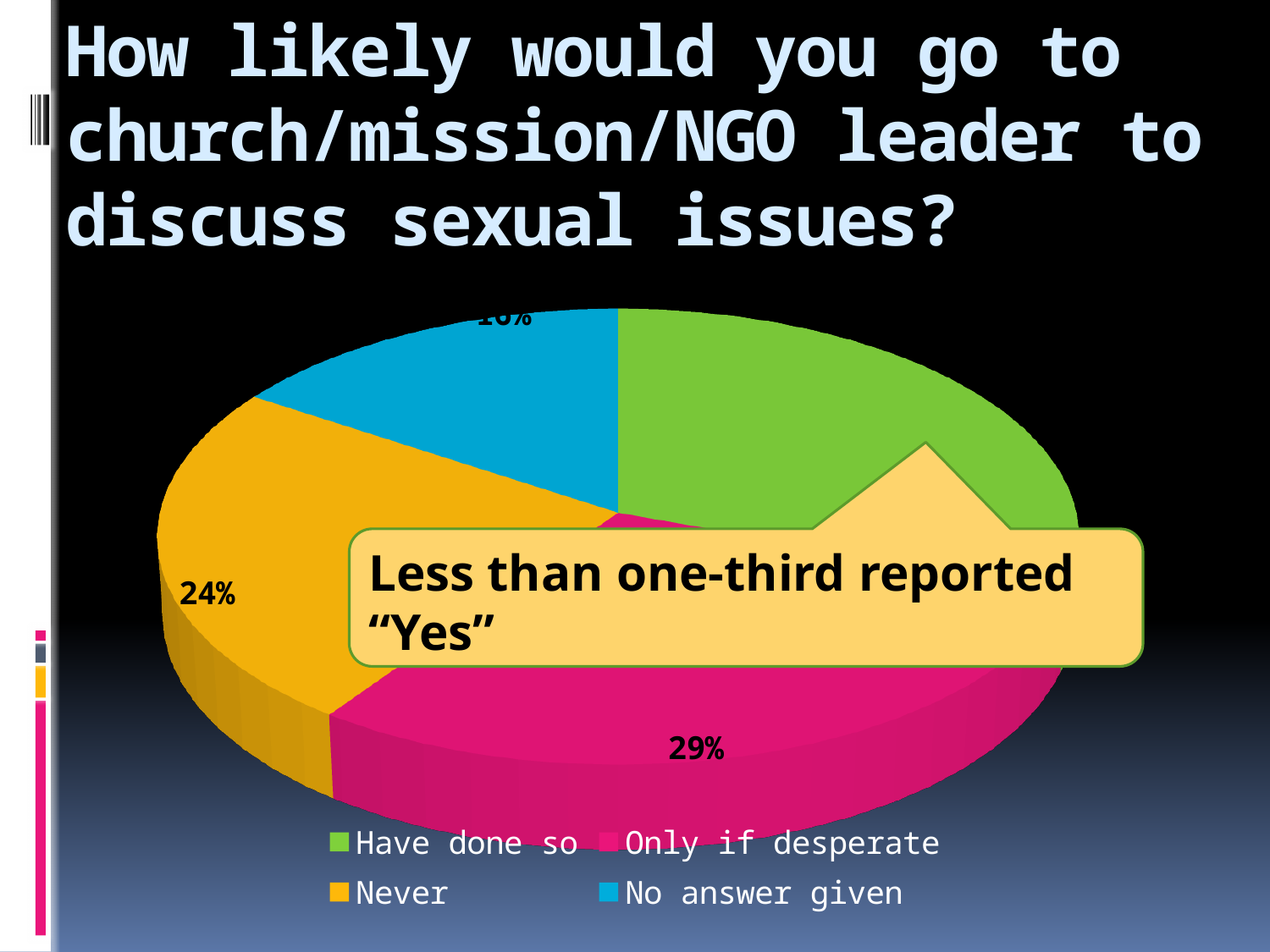
What does the callout box over the pie chart say? Less than one-third reported "Yes" What kind of chart is shown on the slide? pie chart What colour is the "Never" slice in the pie chart? orange What is the difference in percentage points between "Only if desperate" and "Never"? 5 percentage points What percentage of respondents answered "Never"? 24% What percentage of respondents answered "Only if desperate"? 29% Which response category has the smallest slice of the pie? No answer given Is the share for "No answer given" greater or less than 20%? less How many slices does the pie chart have? 4 Which is larger, the share for "Never" or the share for "Only if desperate"? Only if desperate How many entries are listed in the chart legend? 4